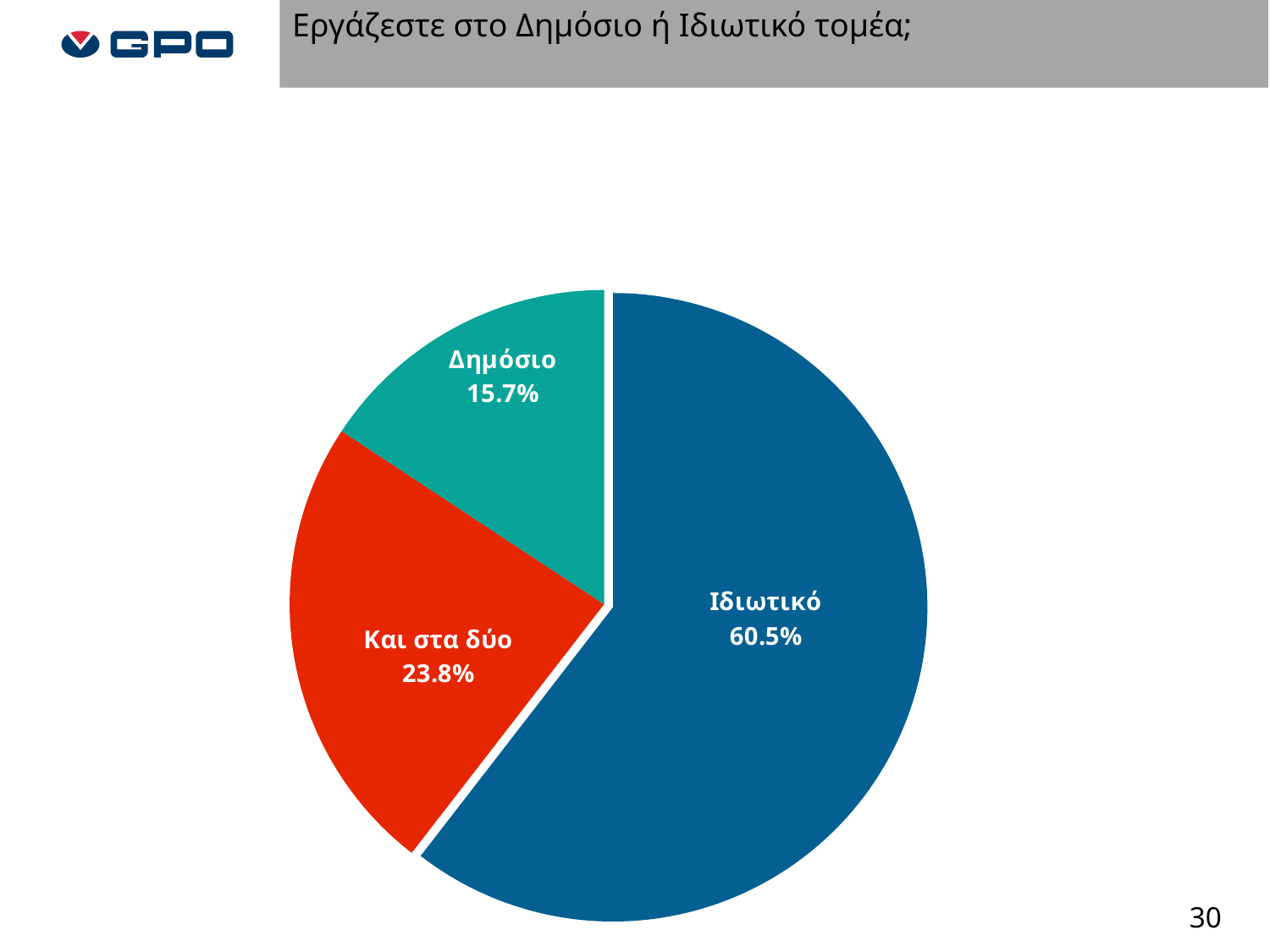
What type of chart is shown on the slide? pie chart How many slices does the pie chart have? 3 What percentage of respondents work in the private sector (Ιδιωτικό)? 60.5% What is the difference in percentage points between Και στα δύο and Δημόσιο? 8.1 Which category has the largest share of the pie? Ιδιωτικό What percentage of respondents work in both sectors (Και στα δύο)? 23.8% Which is larger: the share for Και στα δύο or the share for Δημόσιο? Και στα δύο What is the difference in percentage points between Ιδιωτικό and Δημόσιο? 44.8 Which category has the smallest share of the pie? Δημόσιο What percentage of respondents work in the public sector (Δημόσιο)? 15.7% What is the title of the slide containing the chart? Εργάζεστε στο Δημόσιο ή Ιδιωτικό τομέα; What colour is the slice for Και στα δύο? red